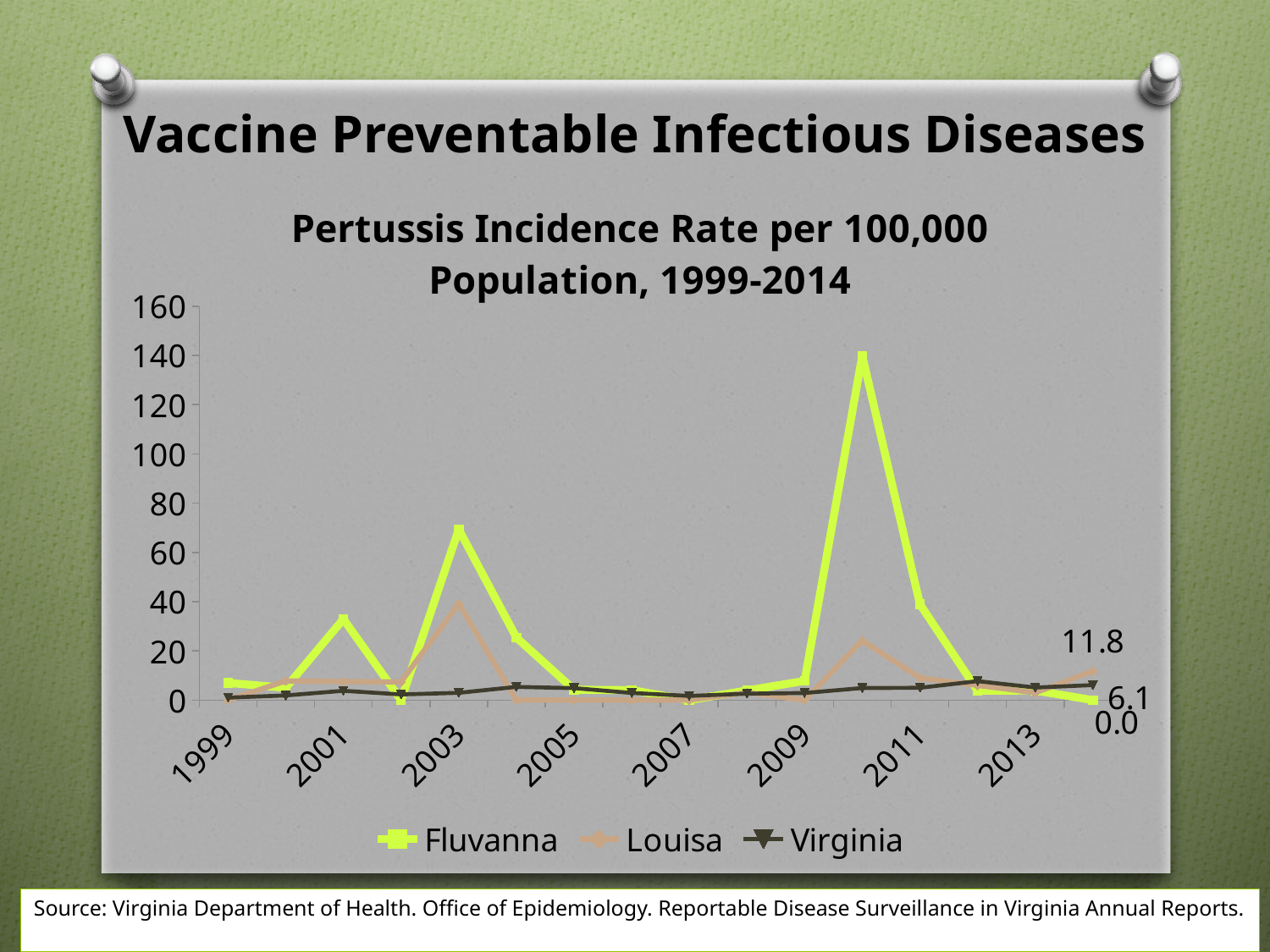
What is the Fluvanna pertussis incidence rate in 2014? 0.0 What is the Louisa pertussis incidence rate in 2014? 11.8 What is the difference between the Louisa and Virginia rates in 2014? 5.7 In 2014, which is larger: the Louisa rate or the Virginia rate? Louisa Which series has the highest value in 2014? Louisa What kind of chart is shown on the slide? line chart Is the Louisa value in 2003 greater or less than 60? less What is the title of the chart? Pertussis Incidence Rate per 100,000 Population, 1999-2014 Which series reaches the highest peak on the chart? Fluvanna What is the Virginia pertussis incidence rate in 2014? 6.1 Is the Fluvanna value at its 2010 peak greater or less than 120? greater How many series does the legend list? 3